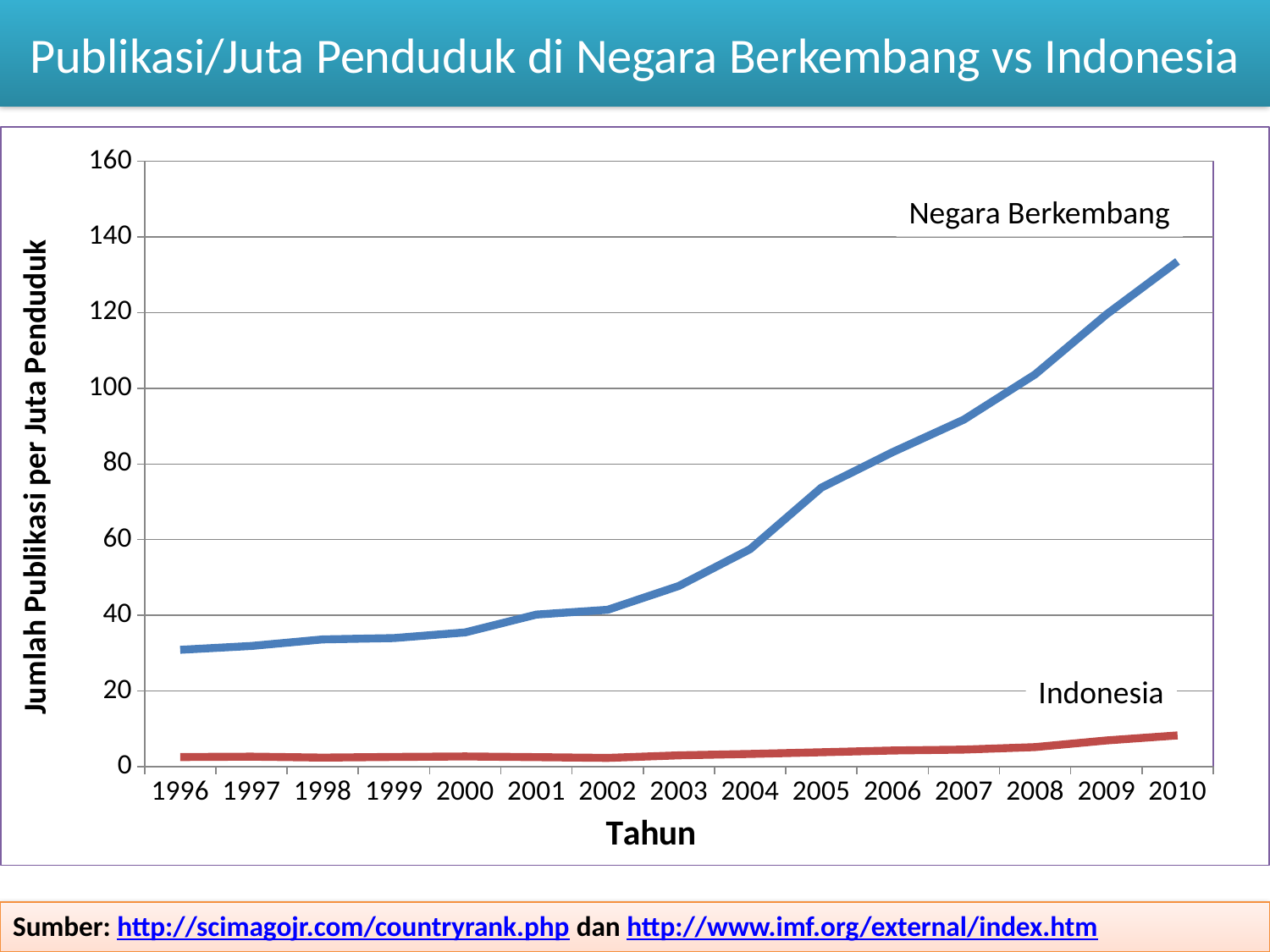
In which year is the value for Negara Berkembang highest? 2010 Is the value for Negara Berkembang in 2010 greater or less than 120? greater Which series has the larger value in 2010, Negara Berkembang or Indonesia? Negara Berkembang Does the value for Negara Berkembang rise or fall from 1996 to 2010? rise What kind of chart is shown on the slide? line chart Is the value for Negara Berkembang in 1996 greater or less than 40? less Is the value for Indonesia in 2010 greater or less than 20? less In which year is the value for Negara Berkembang lowest? 1996 How many series are plotted on the chart? 2 How many years are shown on the x axis? 15 What is the label of the y axis? Jumlah Publikasi per Juta Penduduk